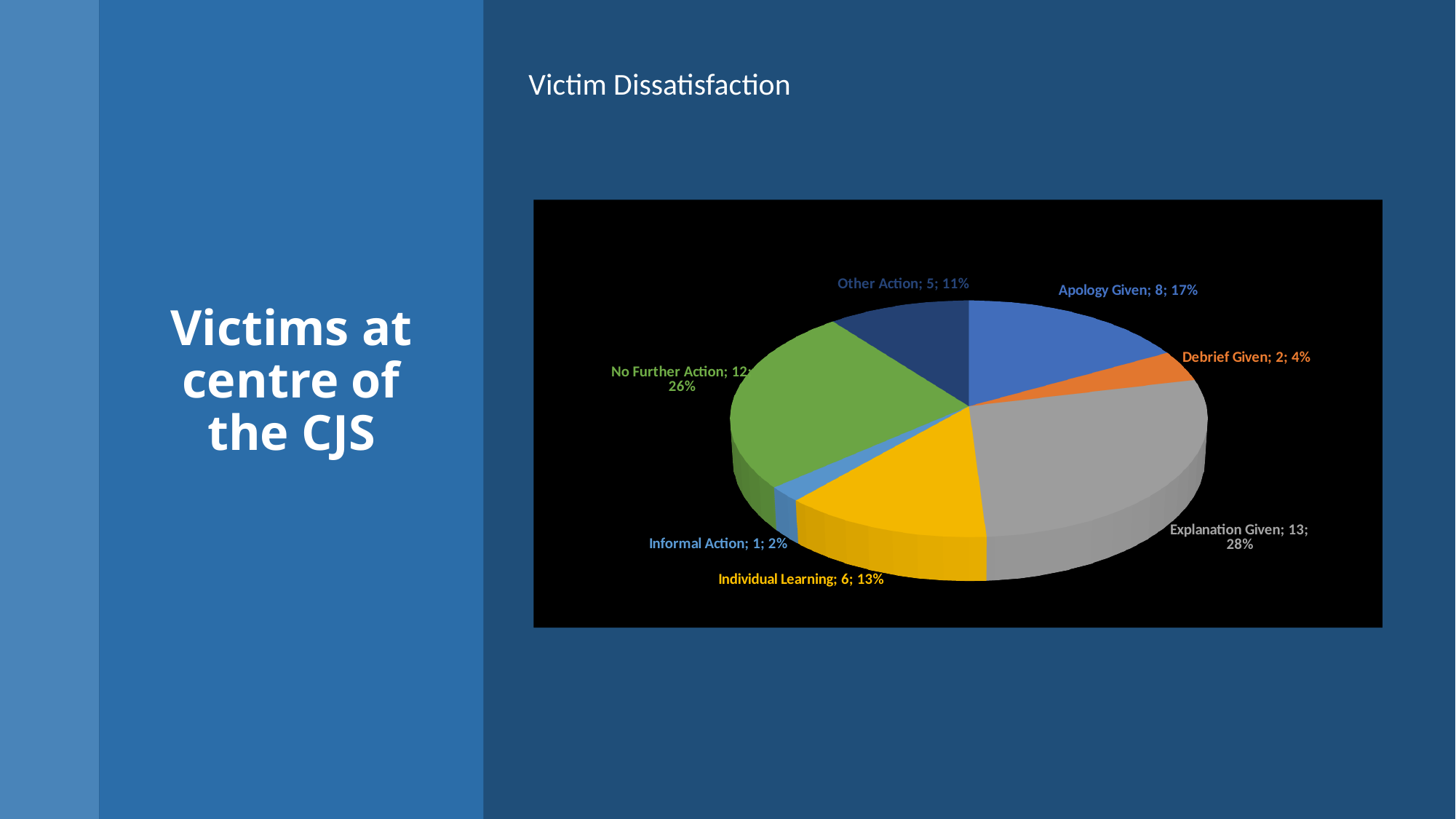
What is the title shown above the chart? Victim Dissatisfaction Which category has the largest slice of the pie? Explanation Given What is the difference between the values for Explanation Given and Other Action? 8 What is the value for Explanation Given? 13 What is the value for Debrief Given? 2 Which is larger, the value for Apology Given or the value for Individual Learning? Apology Given Which category has the smallest slice of the pie? Informal Action What is the value for Apology Given? 8 What share of the pie does Individual Learning represent? 13% How many categories does the pie chart show? 7 What share of the pie does No Further Action represent? 26% What kind of chart is shown on the slide? Pie chart